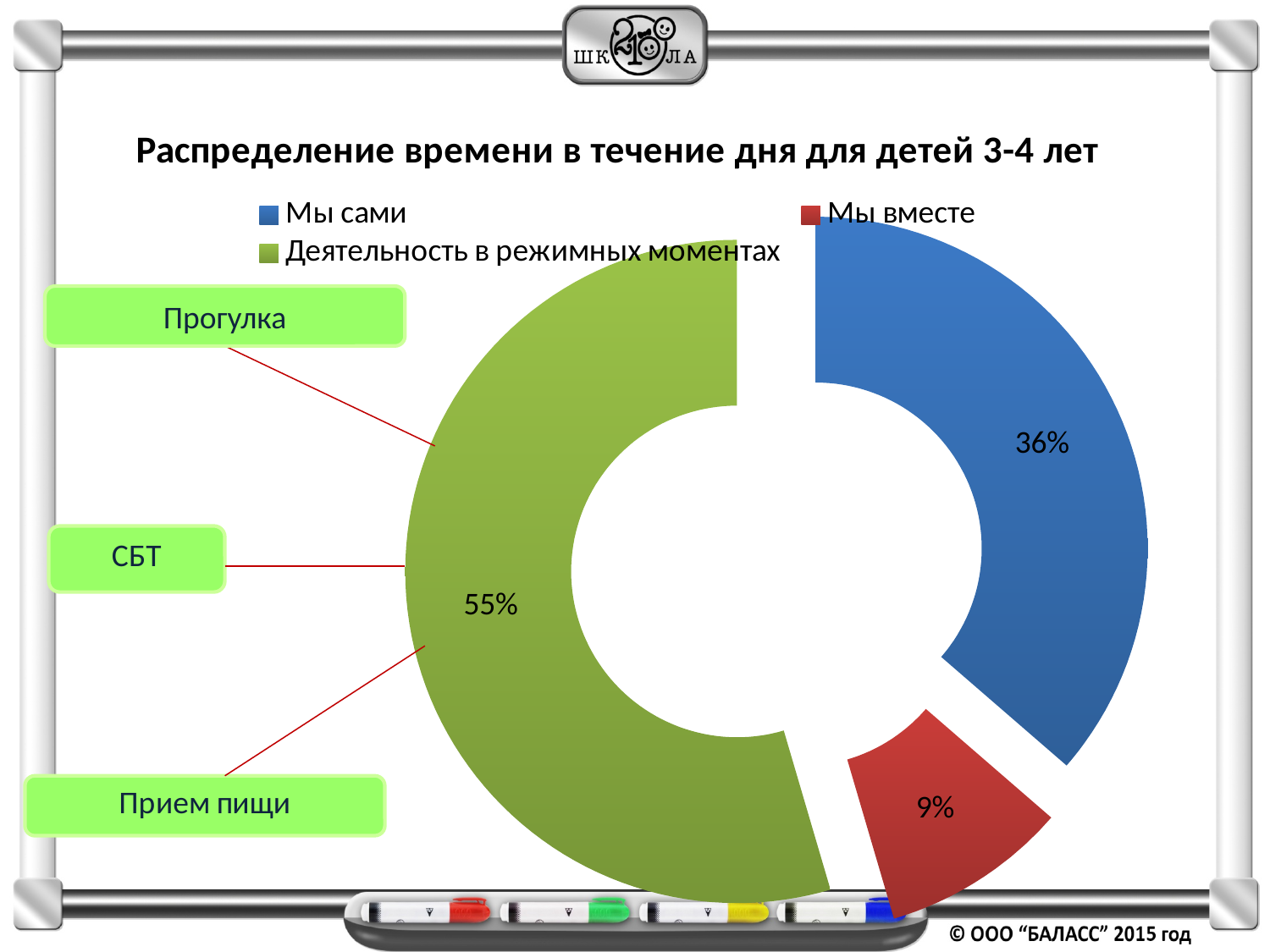
Which category has the largest share of the chart? Деятельность в режимных моментах Which colour represents "Мы вместе" in the chart? Red What is the title of the chart? Распределение времени в течение дня для детей 3-4 лет Which category has the smallest share of the chart? Мы вместе What is the difference in percentage points between "Мы сами" and "Мы вместе"? 27 What kind of chart is shown on the slide? Doughnut (pie) chart What percentage is shown for "Мы вместе"? 9% What percentage is shown for "Деятельность в режимных моментах"? 55% What is the difference in percentage points between "Деятельность в режимных моментах" and "Мы сами"? 19 What percentage is shown for "Мы сами"? 36% How many categories does the chart show? 3 Which is larger, the share for "Мы сами" or the share for "Мы вместе"? Мы сами